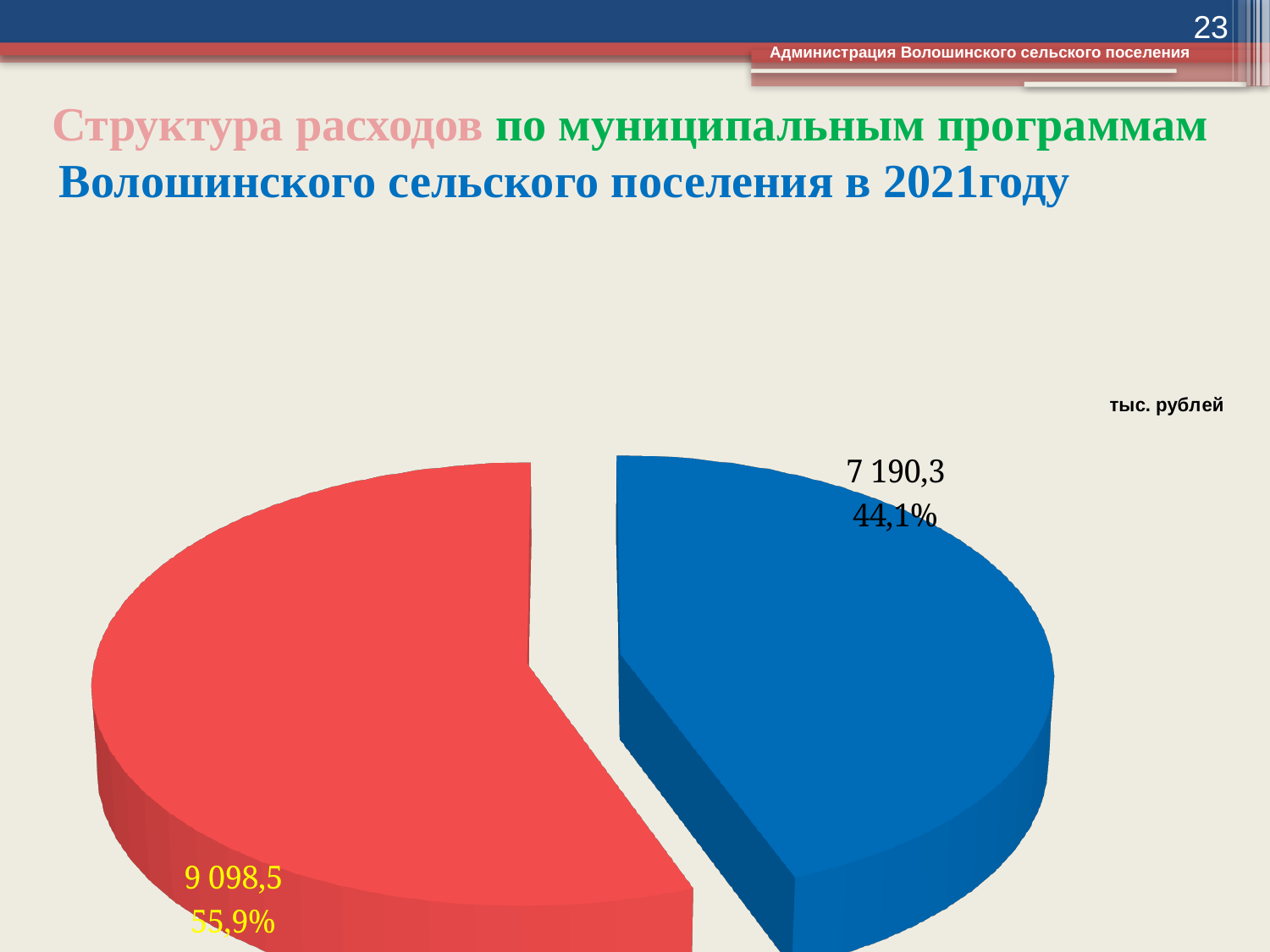
What share of the pie does the blue slice represent? 44,1% In what units are the values on the pie chart expressed, according to the slide? тыс. рублей Which year does the chart title say the expenditure structure refers to? 2021 What is the total of the two values shown on the pie chart? 16 288,8 Which slice of the pie chart has the smallest value? the blue slice How many slices does the pie chart have? 2 What value is printed on the red slice of the pie chart? 9 098,5 Which slice of the pie chart is larger, the red one or the blue one? the red one What kind of chart is shown on the slide? pie chart What share of the pie does the red slice represent? 55,9% What value is printed on the blue slice of the pie chart? 7 190,3 What is the difference between the values of the red slice and the blue slice? 1 908,2